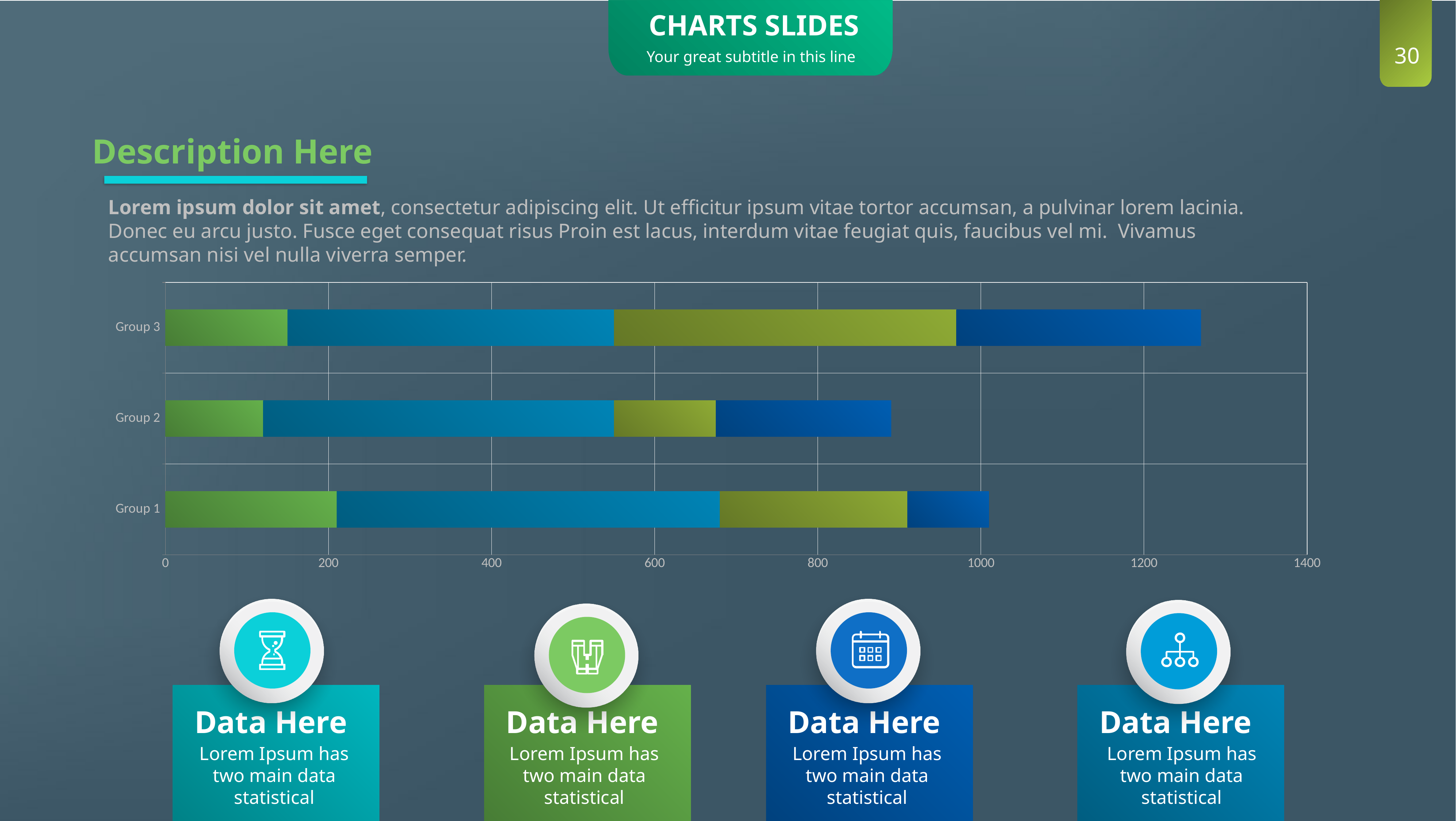
Which has a longer total bar, Group 3 or Group 1? Group 3 How many groups (categories) are plotted on the chart? 3 Which group has the shortest total stacked bar? Group 2 Is the total value for Group 3 greater or less than 1200? greater What is the maximum value shown on the horizontal axis? 1400 How many coloured segments make up each stacked bar? 4 Is the total value for Group 1 greater or less than 800? greater What kind of chart is shown on the slide? bar chart Is the total value for Group 2 greater or less than 800? greater Which has a longer total bar, Group 1 or Group 2? Group 1 Which group has the longest total stacked bar? Group 3